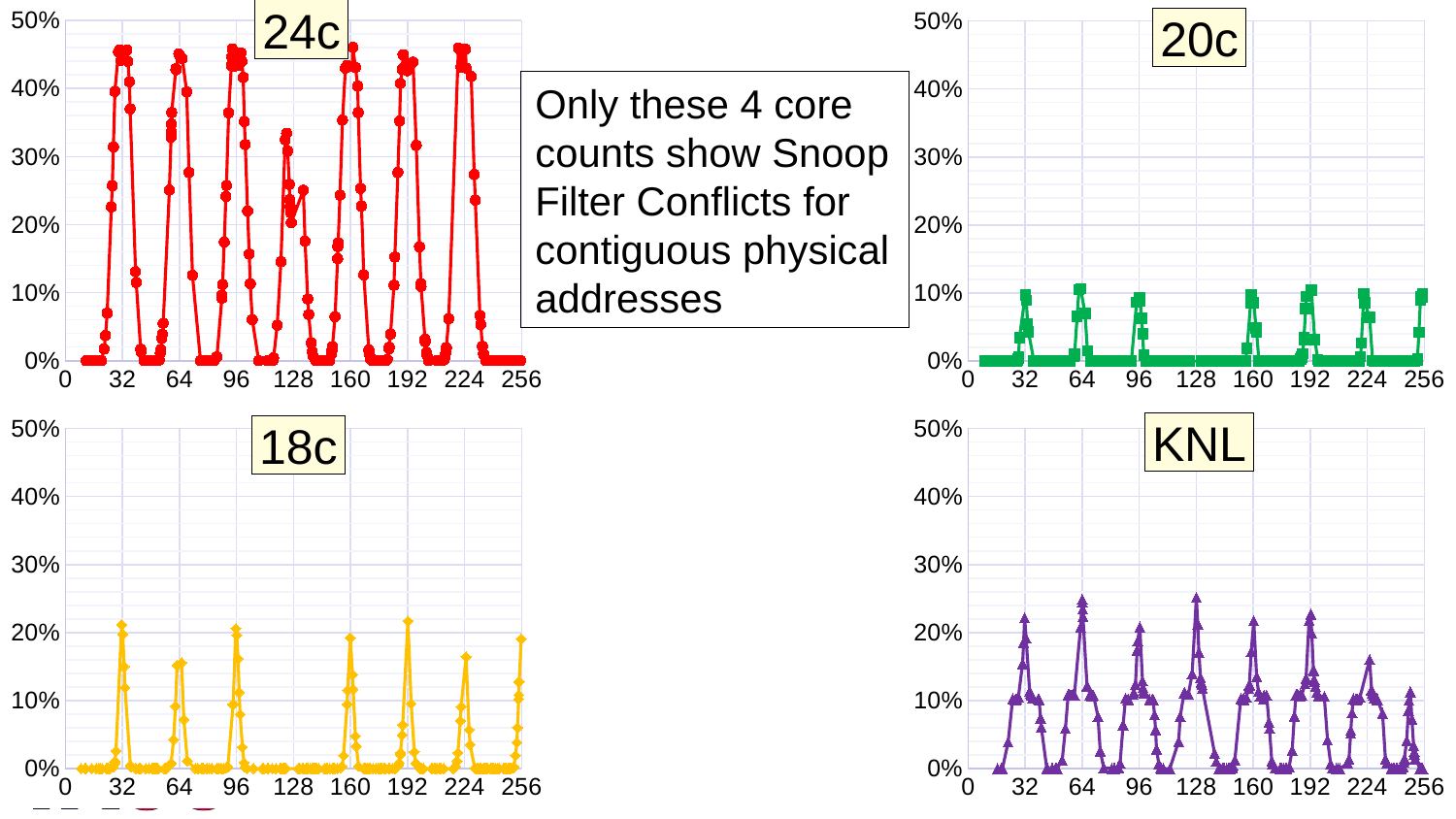
In the KNL chart, is the peak value near x = 128 greater or less than 20%? greater Which chart reaches the highest peak values: 24c, 20c, 18c or KNL? 24c In the 18c chart, is the peak value near x = 32 greater or less than 30%? less What is the maximum value shown on the y axis of the 18c chart? 50% In the 20c chart, is the peak value near x = 64 greater or less than 20%? less Which is larger: the peak near x = 32 in the 24c chart or the peak near x = 32 in the 20c chart? 24c What colour is the line in the KNL chart? purple What kind of chart is the one titled 24c? line chart How many charts are shown on the slide? 4 What is the largest x-axis tick label on the 20c chart? 256